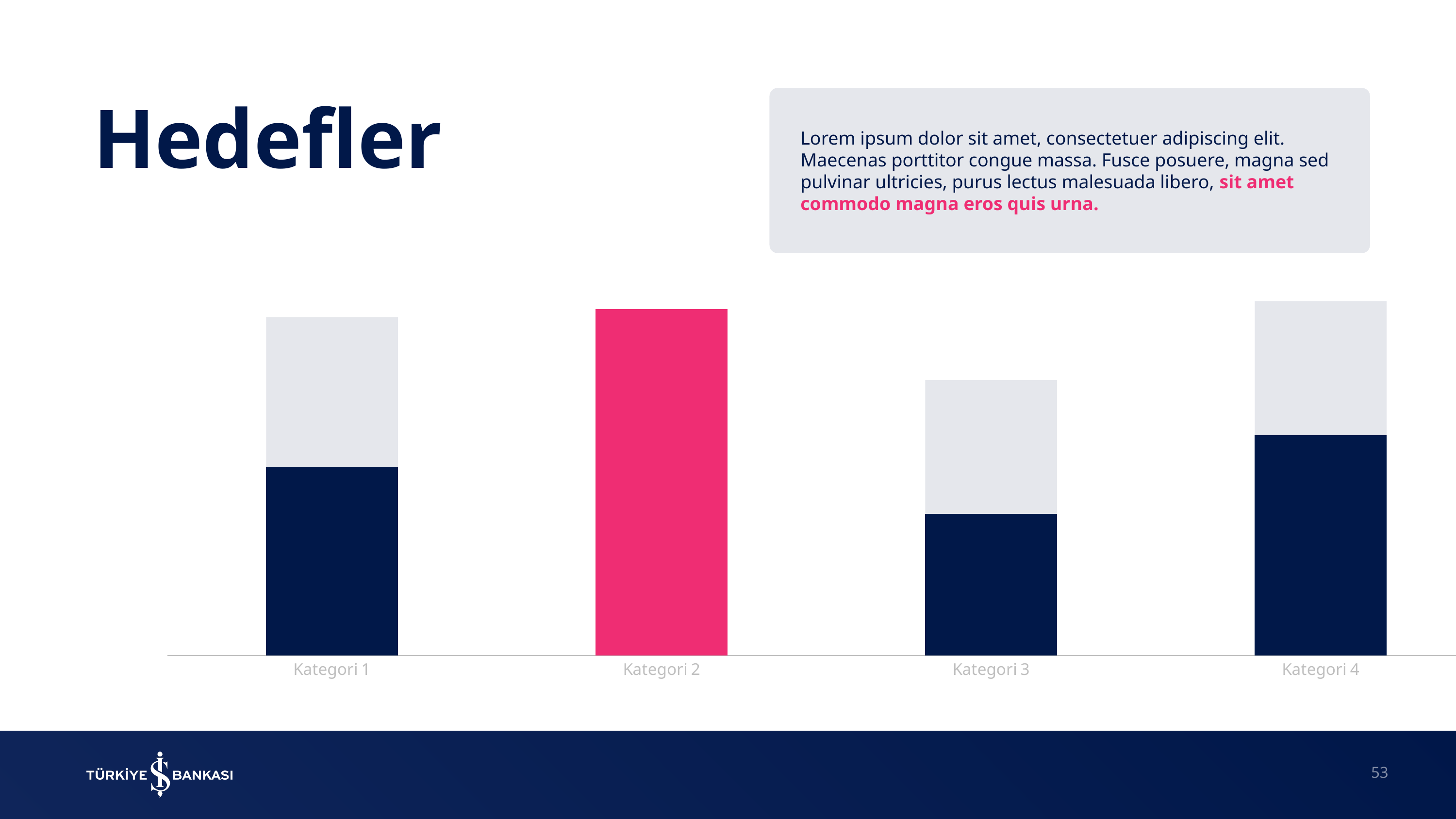
Which category has the tallest dark navy segment? Kategori 4 Which category's bar is highlighted in pink? Kategori 2 Which category has the shortest bar overall? Kategori 3 Which category's dark navy segment is taller, Kategori 1 or Kategori 3? Kategori 1 What is the title of the slide containing the chart? Hedefler Which category has the shortest dark navy segment? Kategori 3 How many categories are shown on the x axis of the chart? 4 Which bar is taller overall, Kategori 2 or Kategori 3? Kategori 2 What kind of chart is shown on the slide? Bar chart Which bar is taller overall, Kategori 1 or Kategori 3? Kategori 1